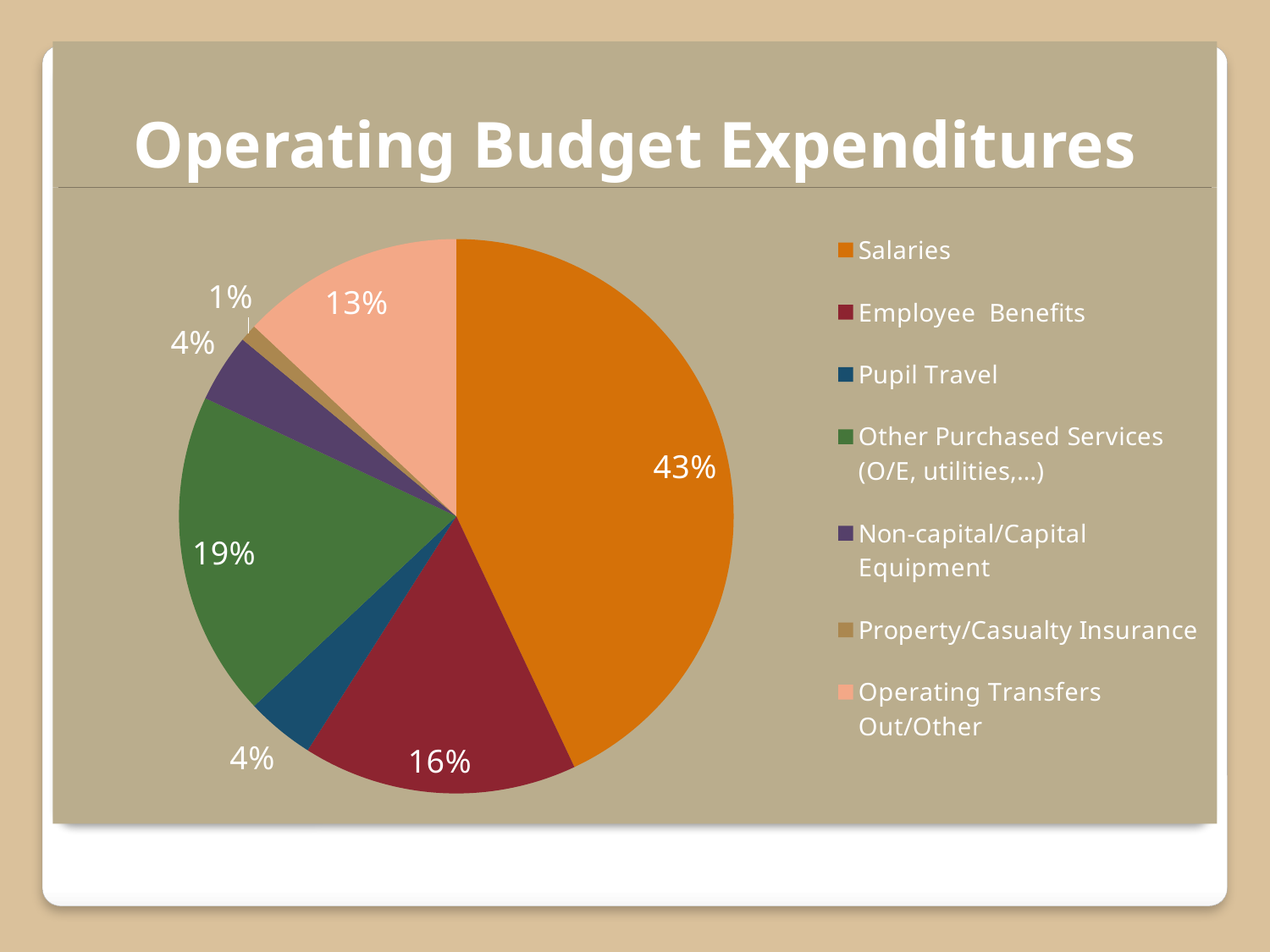
What percentage of the pie is Employee Benefits? 16% What percentage is shown for Property/Casualty Insurance? 1% What is the difference in percentage points between Salaries and Employee Benefits? 27 What is the title of the chart? Operating Budget Expenditures Which category has the smallest share of the pie? Property/Casualty Insurance Which is larger, the share for Other Purchased Services (O/E, utilities,...) or the share for Operating Transfers Out/Other? Other Purchased Services (O/E, utilities,...) Which category has the largest share of the pie? Salaries What percentage is shown for Other Purchased Services (O/E, utilities,...)? 19% How many categories does the legend list? 7 What percentage is shown for Operating Transfers Out/Other? 13% What share of operating budget expenditures goes to Salaries? 43% What kind of chart is shown on the slide? pie chart